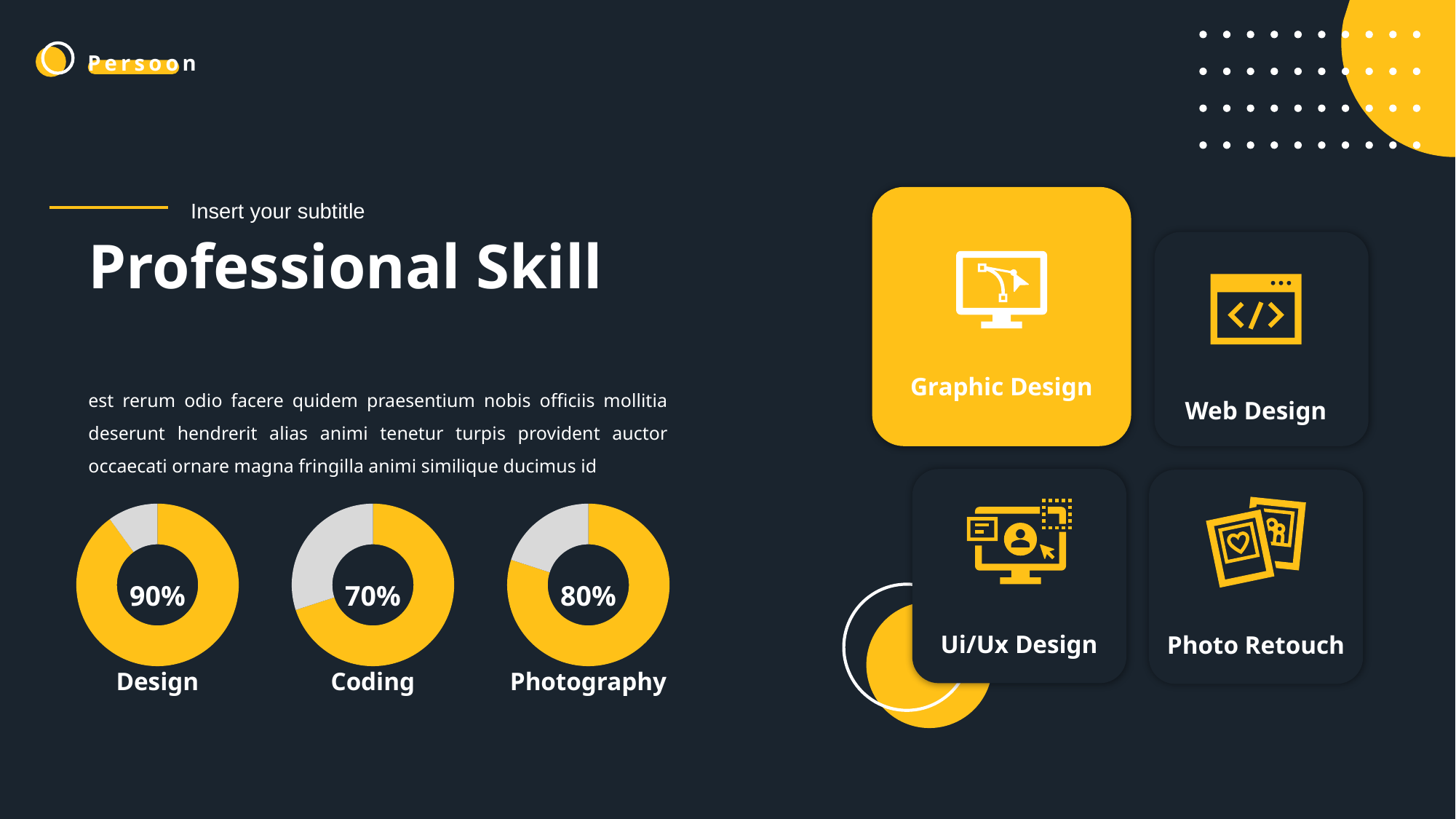
How many donut charts are shown on the slide? 3 What is the title of the slide containing the skill charts? Professional Skill What is the difference between the Photography percentage and the Coding percentage? 10% What kind of chart is used to show the skill percentages? Donut chart What percentage is shown in the Photography donut chart? 80% What percentage is shown in the Coding donut chart? 70% What colour is the filled portion of each donut chart? Yellow Which of the three skill charts shows the highest percentage? Design Which is larger, the Coding percentage or the Photography percentage? Photography Which of the three skill charts shows the lowest percentage? Coding What percentage is shown in the Design donut chart? 90% What is the difference between the Design percentage and the Coding percentage? 20%